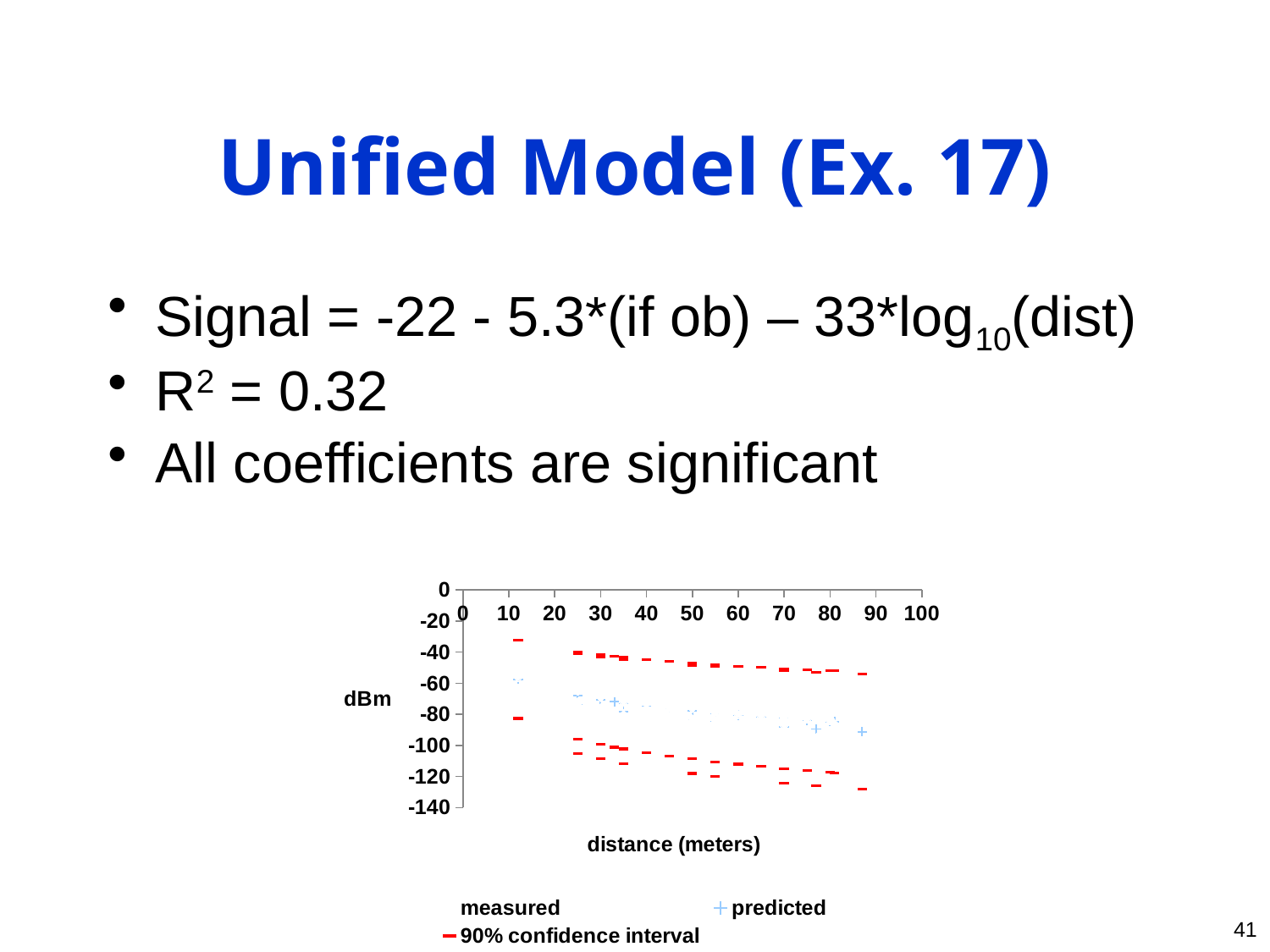
What is the title of the chart's x axis? distance (meters) Is the upper 90% confidence interval value at about 90 meters greater or less than -60? greater What kind of chart is shown on the slide? scatter chart Is the upper 90% confidence interval value at about 10 meters greater or less than -40? greater Is the lower 90% confidence interval value at about 90 meters greater or less than -120? less Does the lower 90% confidence interval bound rise or fall as distance increases? fall How many series does the chart's legend list? 3 Do the predicted values rise or fall as distance increases along the x axis? fall What label is shown on the chart's y axis? dBm